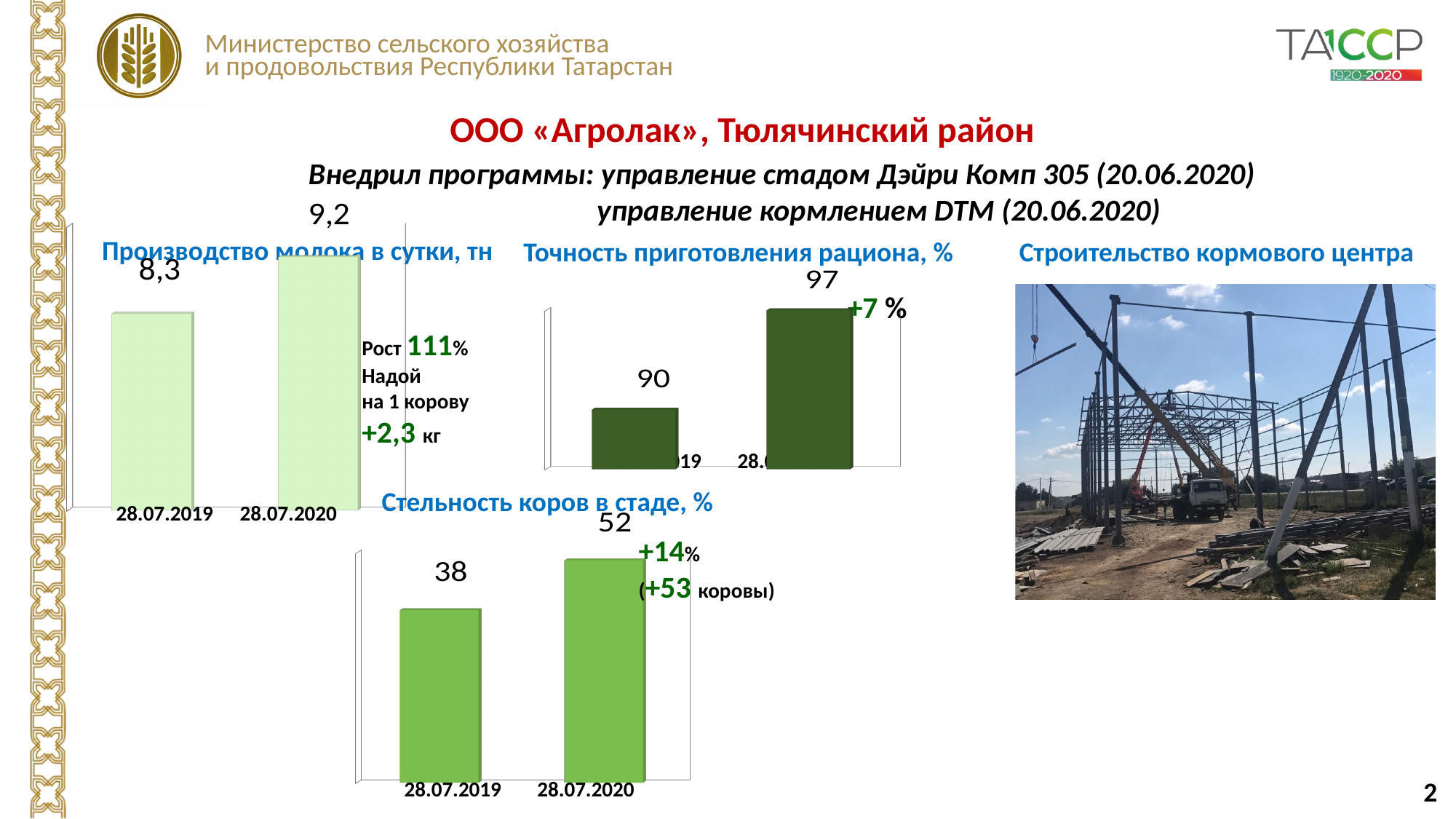
In the chart 'Точность приготовления рациона, %', what is the difference between the right bar and the left bar? 7 In the chart 'Стельность коров в стаде, %', what is the value for 28.07.2020? 52 In the chart 'Стельность коров в стаде, %', what is the difference between the 28.07.2020 and 28.07.2019 values? 14 In the chart 'Производство молока в сутки, тн', which date has the higher value? 28.07.2020 How many bars are in the chart 'Стельность коров в стаде, %'? 2 In the chart 'Точность приготовления рациона, %', what is the value of the right bar? 97 In the chart 'Стельность коров в стаде, %', which date has the lower value? 28.07.2019 In the chart 'Производство молока в сутки, тн', what is the value for 28.07.2019? 8,3 In the chart 'Точность приготовления рациона, %', what is the value of the left bar? 90 What type of chart is 'Производство молока в сутки, тн'? Bar chart In the chart 'Стельность коров в стаде, %', what is the value for 28.07.2019? 38 In the chart 'Производство молока в сутки, тн', what is the value for 28.07.2020? 9,2